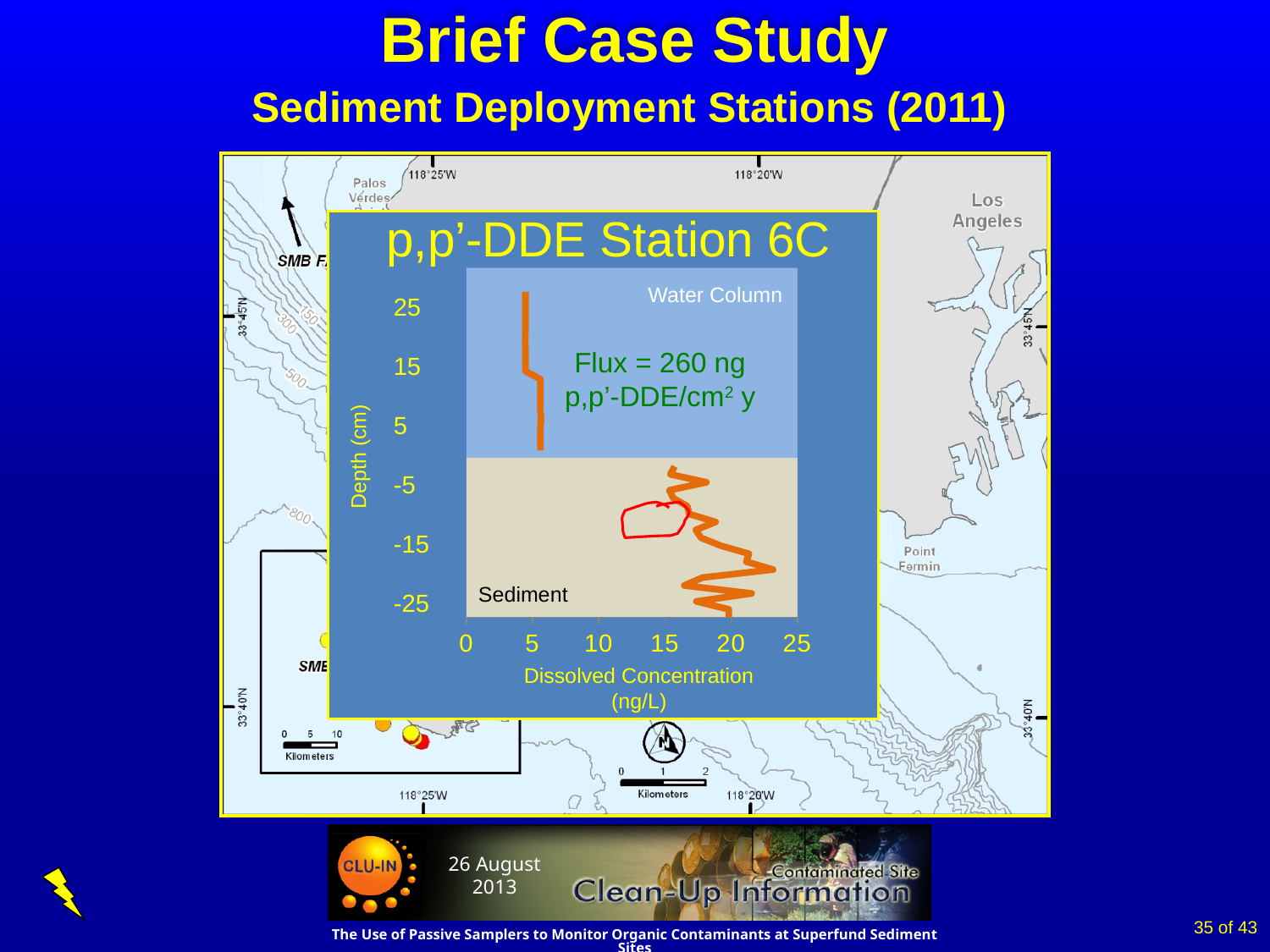
In the p,p'-DDE Station 6C chart, which region shows higher dissolved concentrations, the water column or the sediment? Sediment How many tick labels are shown on the x axis of the p,p'-DDE Station 6C chart? 6 What flux value is annotated on the p,p'-DDE Station 6C chart? 260 ng p,p'-DDE/cm² y In the p,p'-DDE Station 6C chart, is the dissolved concentration at a depth of 25 cm greater or less than 10 ng/L? less What kind of chart is the p,p'-DDE Station 6C chart? line chart What is the label of the x axis of the p,p'-DDE Station 6C chart? Dissolved Concentration (ng/L) In the p,p'-DDE Station 6C chart, is the dissolved concentration at a depth of -25 cm greater or less than 15 ng/L? greater What is the title of the chart shown on the slide? p,p'-DDE Station 6C In the p,p'-DDE Station 6C chart, is the dissolved concentration at a depth of -15 cm greater or less than 10 ng/L? greater What is the lowest depth value labelled on the y axis of the p,p'-DDE Station 6C chart? -25 In the p,p'-DDE Station 6C chart, does the dissolved concentration increase or decrease when moving from the water column down into the sediment? increase What is the highest value labelled on the x axis of the p,p'-DDE Station 6C chart? 25